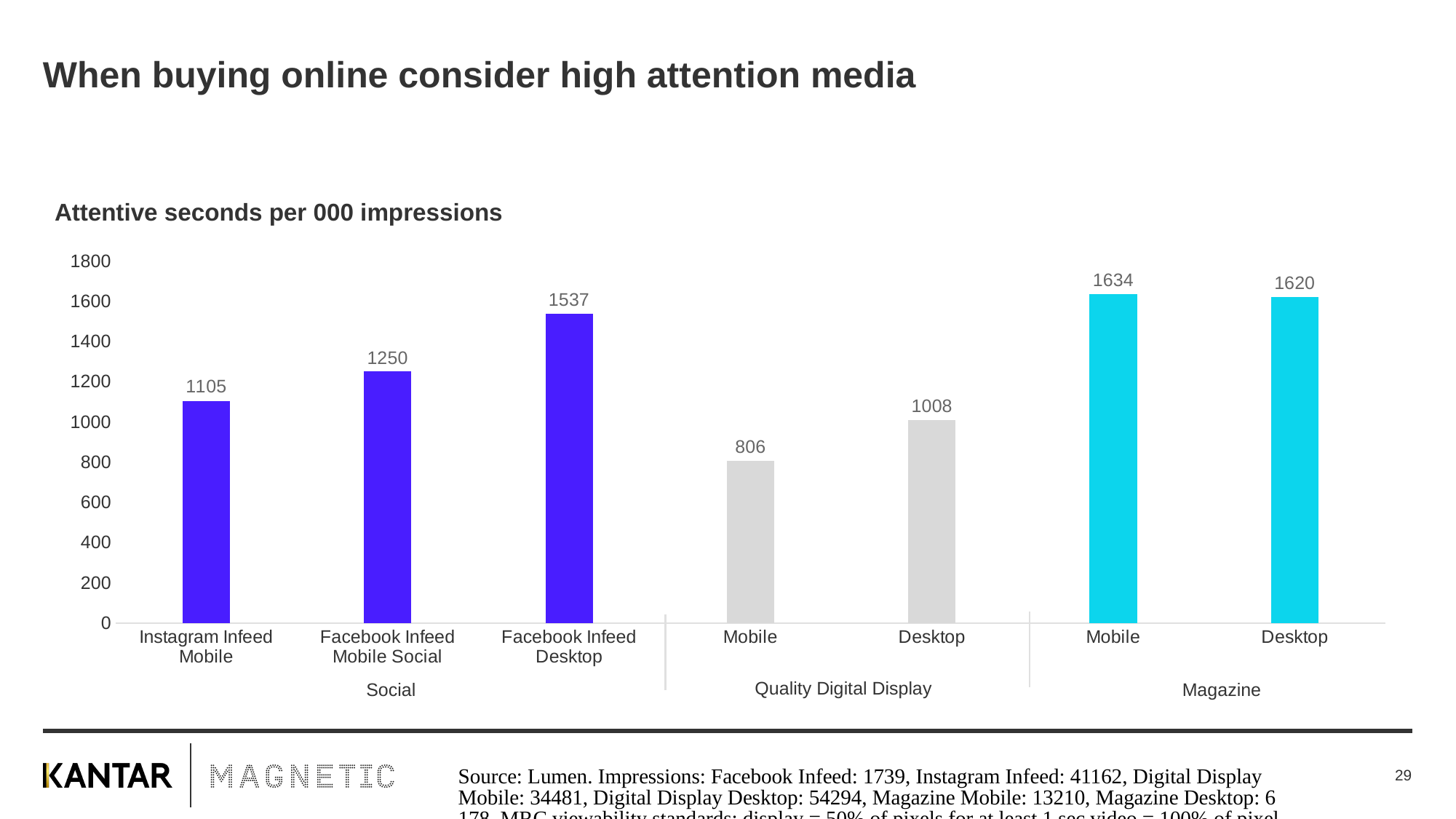
What is the value for Facebook Infeed Desktop? 1537 Which category has the lowest value? Quality Digital Display Mobile Which is larger, Quality Digital Display Desktop or Instagram Infeed Mobile? Instagram Infeed Mobile What is the value for Quality Digital Display Mobile? 806 Is the value for Quality Digital Display Desktop greater or less than 1200? less How many bars are plotted in the chart? 7 What kind of chart is shown? Bar chart Which category has the highest value? Magazine Mobile What is the title of the chart? Attentive seconds per 000 impressions What is the value for Magazine Desktop? 1620 What is the difference between Facebook Infeed Desktop and Facebook Infeed Mobile Social? 287 What is the value for Instagram Infeed Mobile? 1105